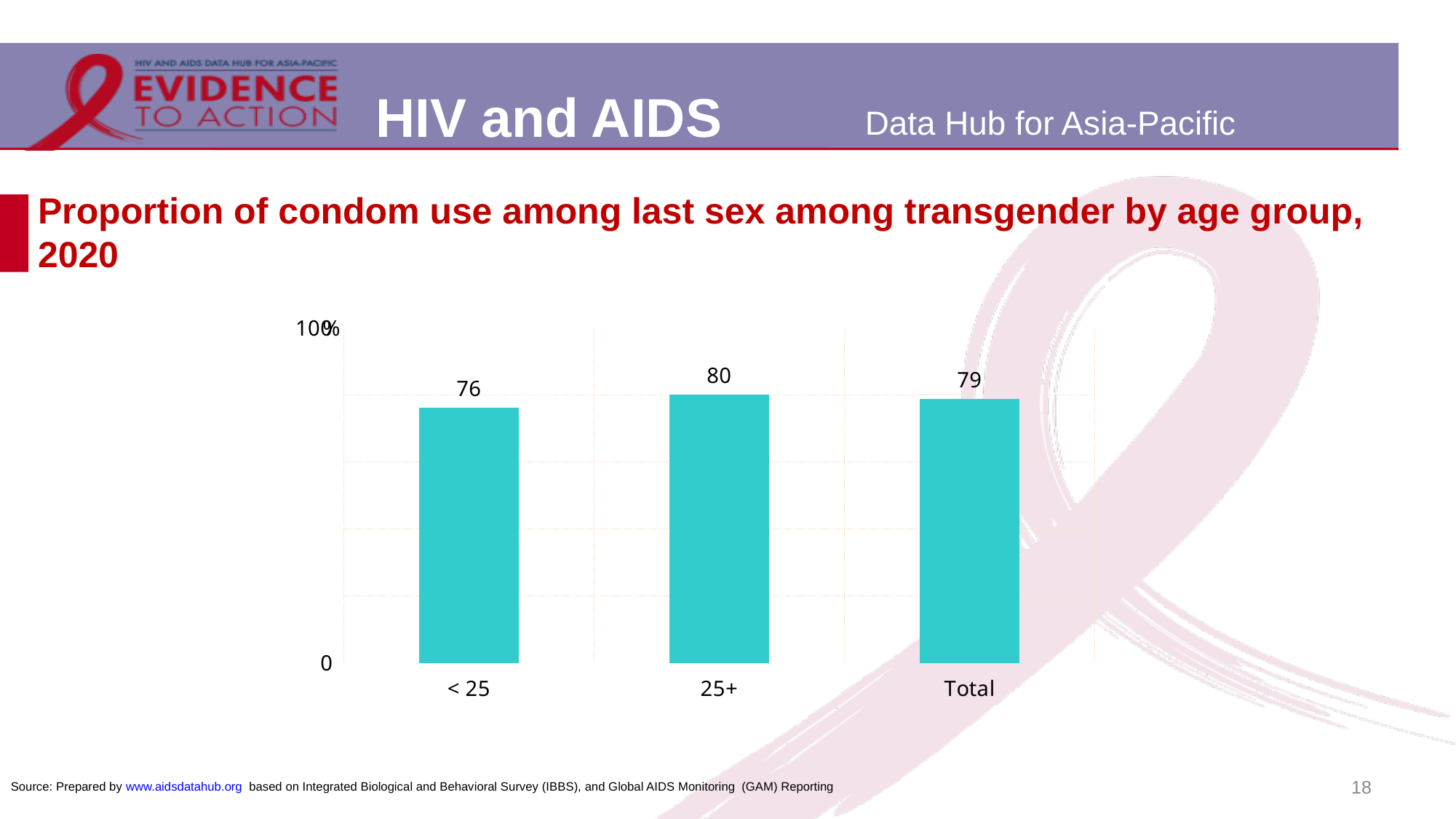
What kind of chart is shown on the slide? bar chart What is the value for the 25+ age group? 80 What is the difference between the values for Total and < 25? 3 What is the value for the < 25 age group? 76 How many categories are shown on the x axis? 3 What is the difference between the values for 25+ and < 25? 4 What is the value for Total? 79 Which category has the highest value? 25+ Which category has the lowest value? < 25 What is the maximum value shown on the y axis? 100% What is the title of the chart on the slide? Proportion of condom use among last sex among transgender by age group, 2020 Which is larger, the value for < 25 or the value for 25+? 25+